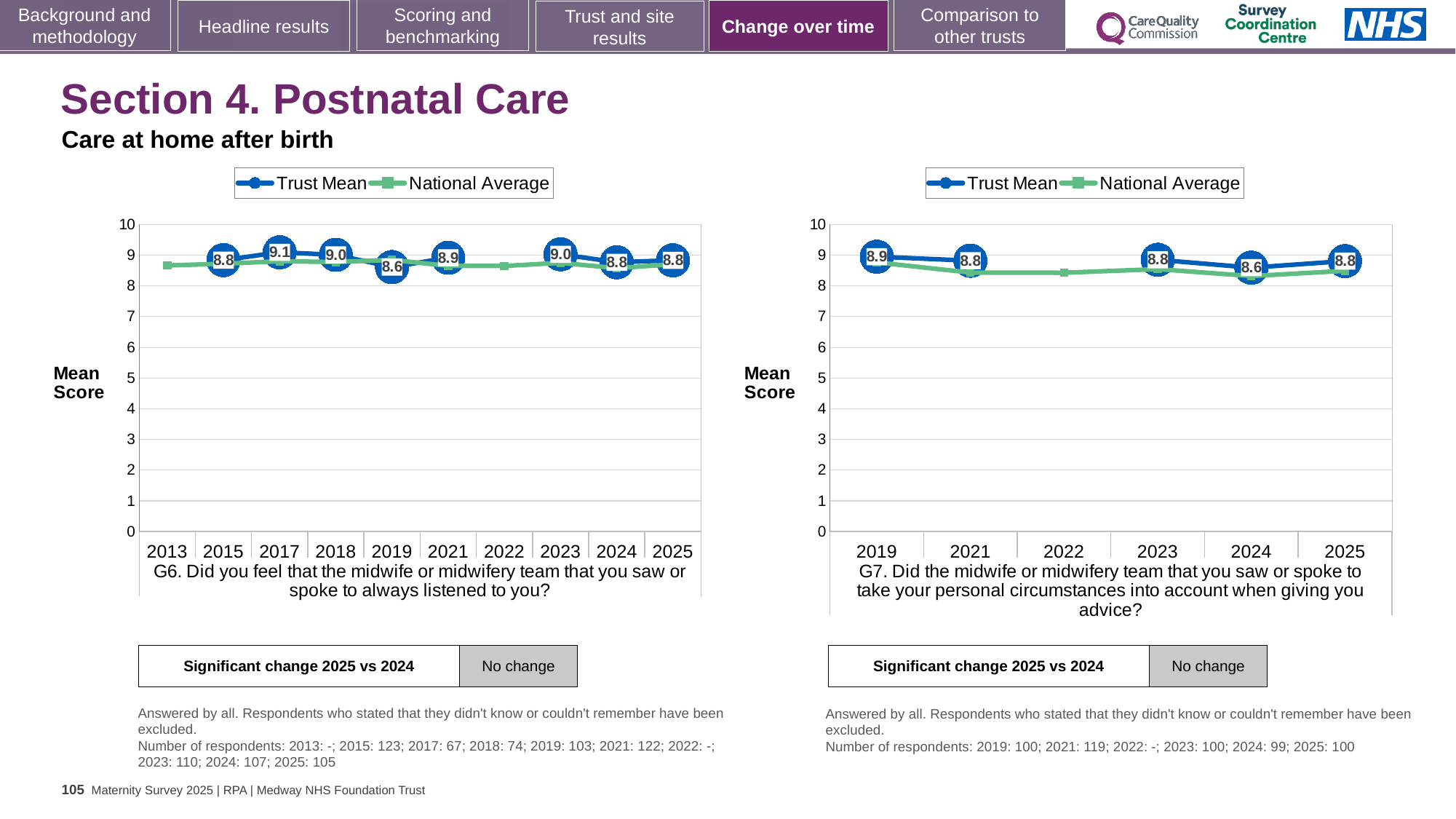
In the G6 chart on the left, what is the Trust Mean for 2019? 8.6 In the G7 chart on the right, what is the Trust Mean for 2024? 8.6 In the G6 chart on the left, which year has the highest Trust Mean? 2017 In the G6 chart on the left, which year has the lowest labelled Trust Mean? 2019 In the G7 chart on the right, which year has the highest Trust Mean? 2019 In the G7 chart on the right, is the Trust Mean for 2019 larger or smaller than the Trust Mean for 2024? Larger In the G7 chart on the right, how many series does the legend list? 2 What kind of chart is the G7 chart on the right? Line chart In the G6 chart on the left, what is the Trust Mean for 2017? 9.1 In the G6 chart on the left, how many years are shown on the x axis? 10 In the G6 chart on the left, what is the difference between the Trust Mean in 2017 and in 2019? 0.5 In the G7 chart on the right, is the Trust Mean for 2025 greater or less than 8? greater